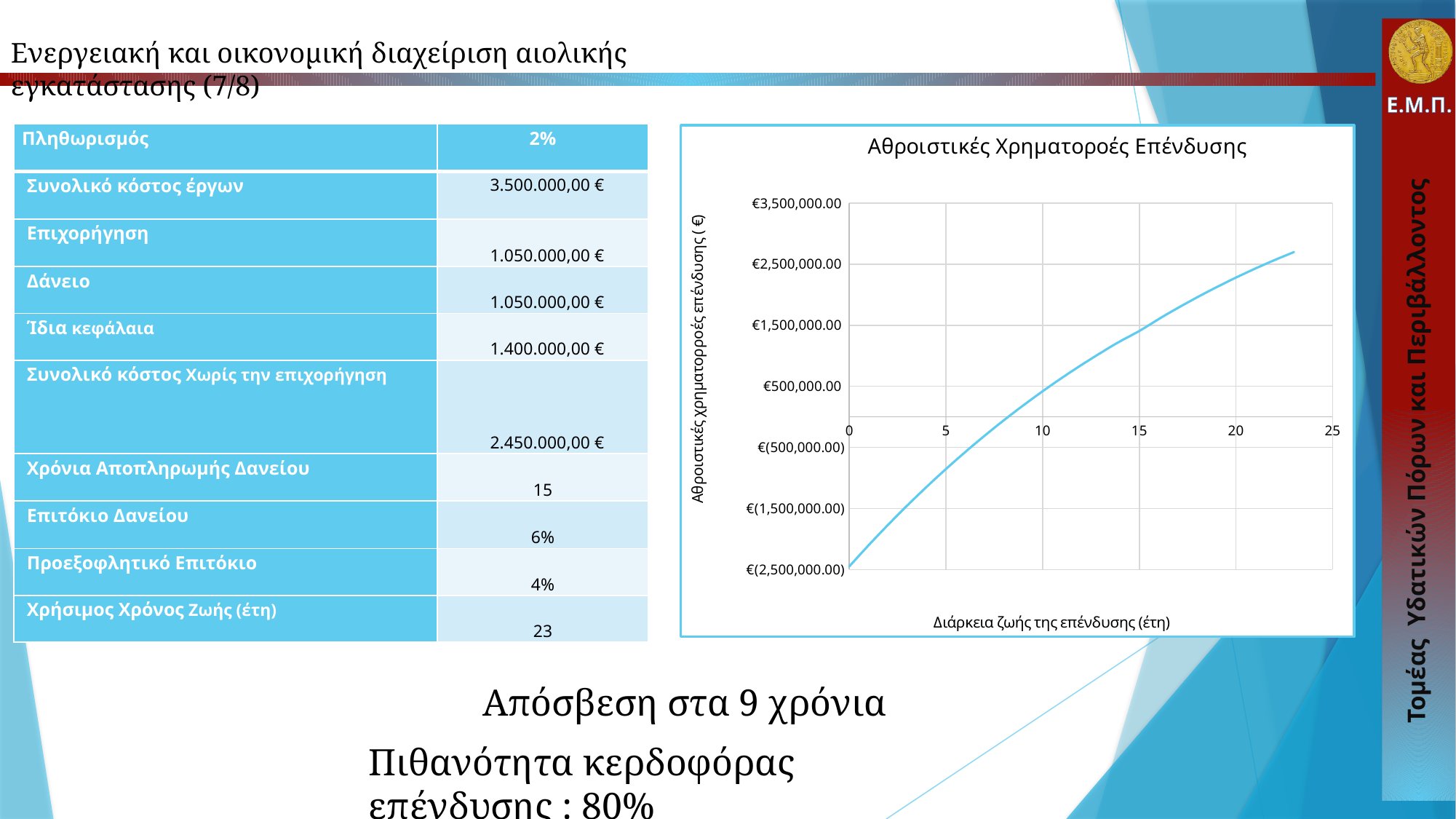
At which year on the x axis is the cumulative cash flow lowest? 0 Is the cumulative cash flow value at year 0 greater or less than €(1,500,000.00)? less What kind of chart is shown on the slide? line chart What is the title of the chart? Αθροιστικές Χρηματοροές Επένδυσης Is the cumulative cash flow value at year 15 greater or less than €500,000.00? greater Is the cumulative cash flow value at year 5 greater or less than €(500,000.00)? less What is the label of the x axis of the chart? Διάρκεια ζωής της επένδυσης (έτη) What is the highest value shown on the y axis of the chart? €3,500,000.00 Do the cumulative cash flow values rise or fall as the years increase along the x axis? rise Which is larger, the cumulative cash flow at year 5 or at year 20? year 20